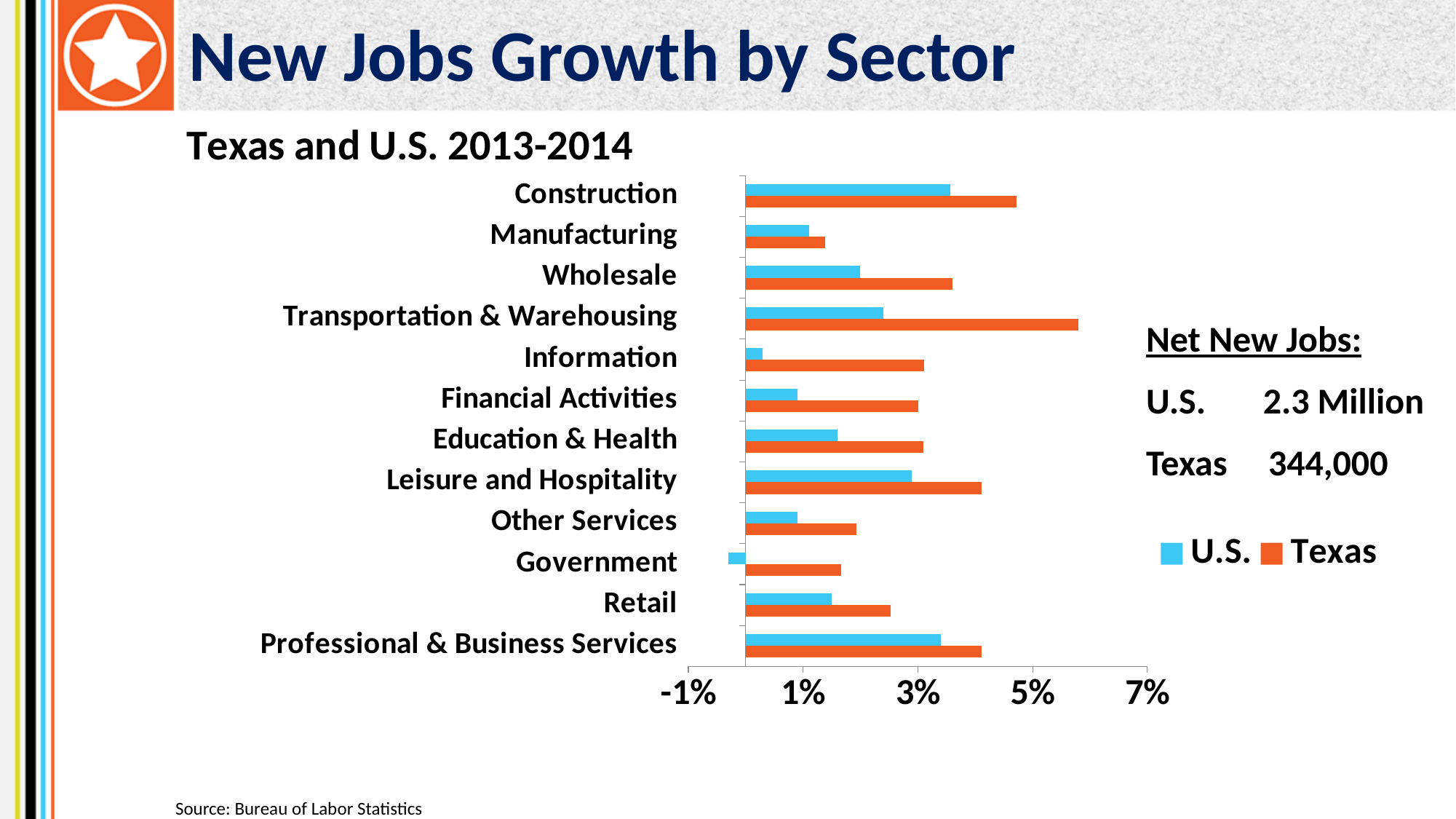
Is the Texas value for Wholesale greater or less than 3%? greater Is the U.S. value for Information greater or less than 1%? less What is the subtitle shown above the chart? Texas and U.S. 2013-2014 What kind of chart is shown on the slide? bar chart Is the Texas value for Transportation & Warehousing greater or less than 5%? greater How many sectors are listed on the chart? 12 Which colour represents Texas in the chart? orange Which sector has the lowest U.S. value? Government Which sector has the highest Texas value? Transportation & Warehousing How many series does the legend list? 2 For Transportation & Warehousing, which is larger, the U.S. value or the Texas value? Texas